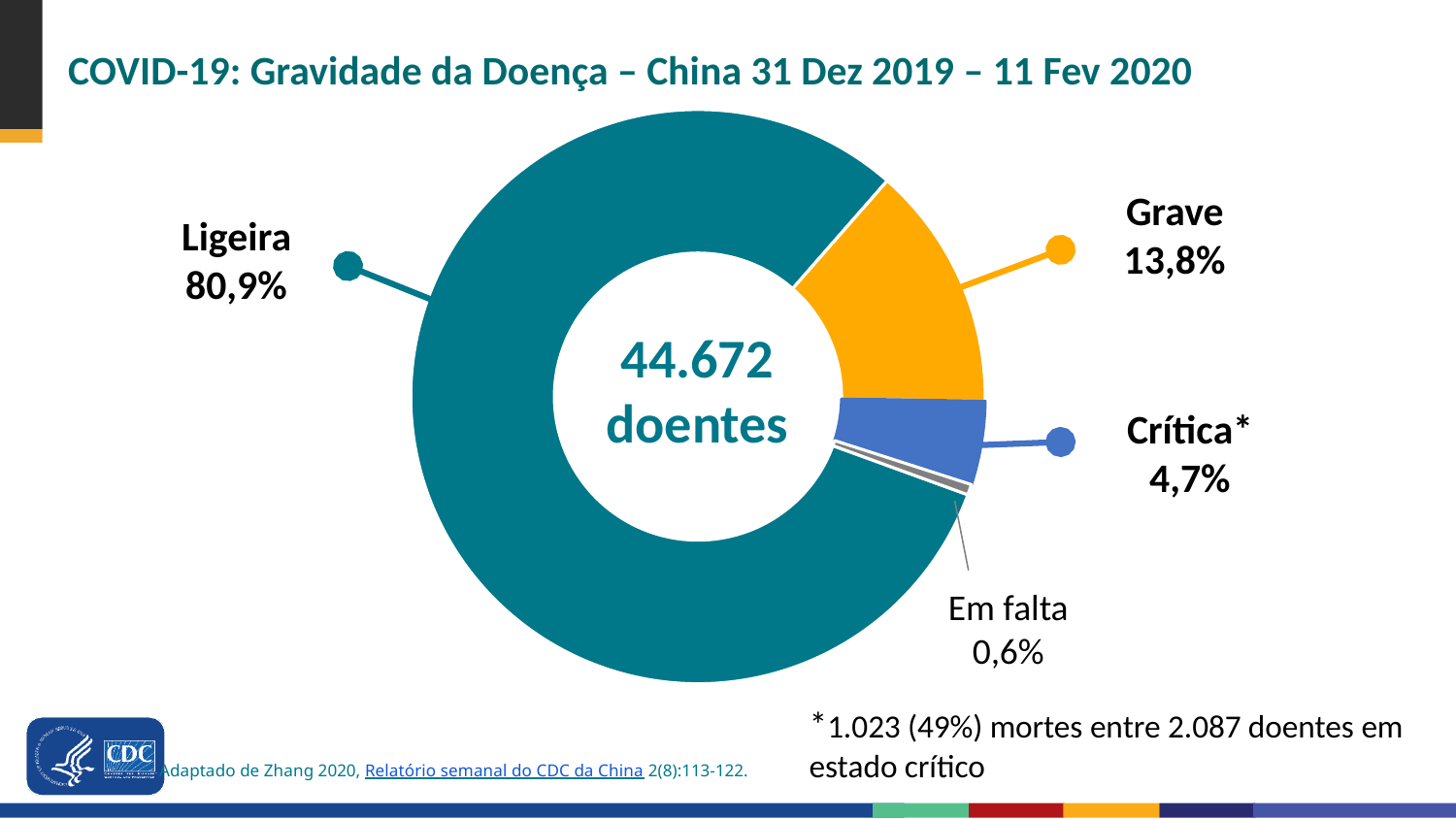
Which is larger, the share for Grave or the share for Crítica*? Grave What share of patients is labelled 'Em falta' (missing)? 0,6% Which category has the largest share of the pie? Ligeira What kind of chart is shown on the slide? Pie chart (donut) What is the difference in percentage points between the Grave and Crítica* shares? 9,1 Which category has the smallest share of the pie? Em falta What total number of patients is shown in the centre of the chart? 44.672 doentes What share of patients had critical (Crítica*) disease? 4,7% What is the title of the chart? COVID-19: Gravidade da Doença – China 31 Dez 2019 – 11 Fev 2020 What share of patients had severe (Grave) disease? 13,8% What share of patients had mild (Ligeira) disease? 80,9% How many categories are shown in the pie chart? 4